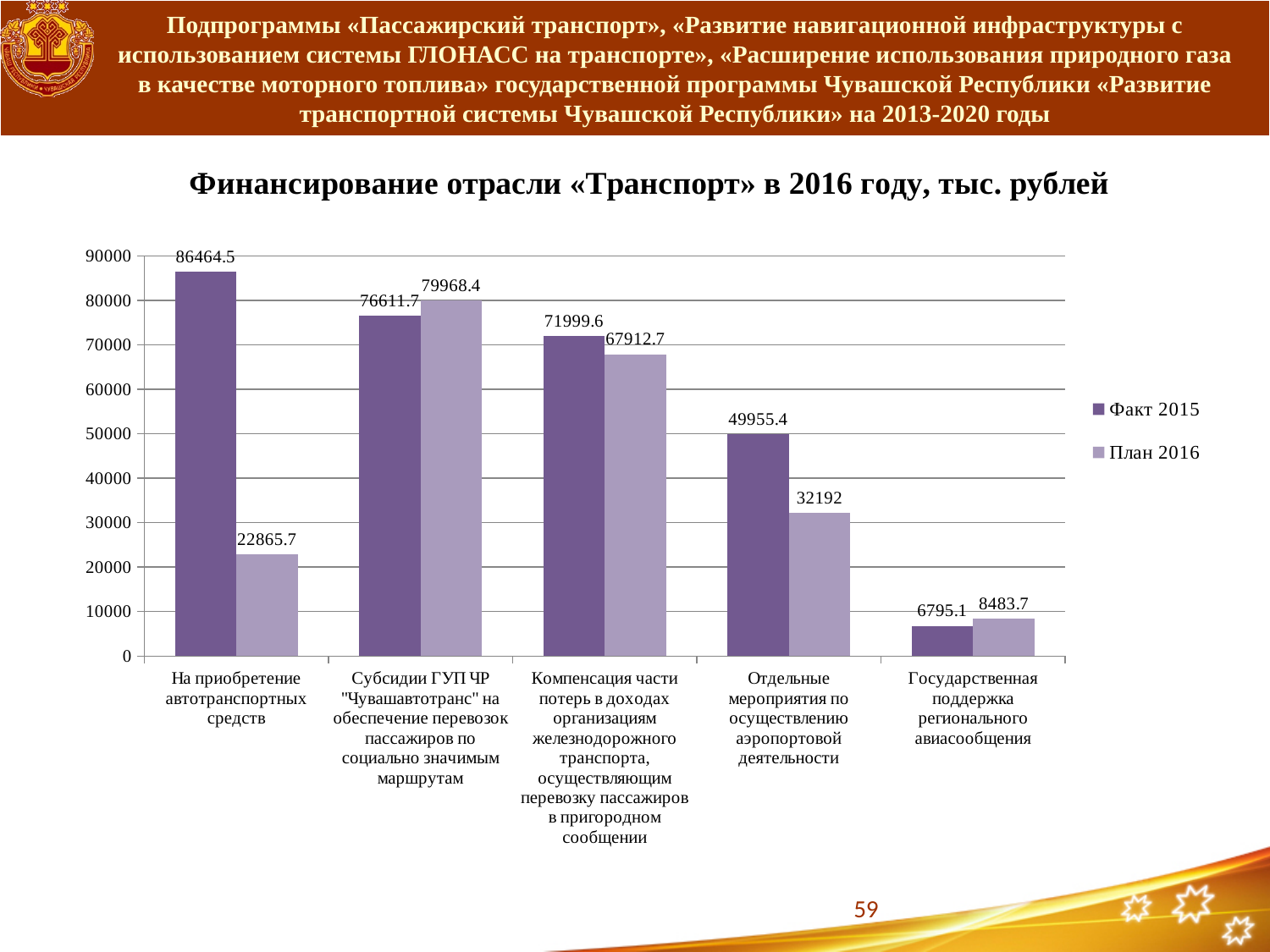
How many series does the legend list? 2 For «Компенсация части потерь в доходах организациям железнодорожного транспорта...», which is larger: Факт 2015 or План 2016? Факт 2015 What is the Факт 2015 value for «На приобретение автотранспортных средств»? 86464.5 How many categories are shown on the x axis? 5 Which category has the highest Факт 2015 value? На приобретение автотранспортных средств What is the План 2016 value for «Отдельные мероприятия по осуществлению аэропортовой деятельности»? 32192 What is the difference between the Факт 2015 and План 2016 values for «На приобретение автотранспортных средств»? 63598.8 What is the План 2016 value for «Государственная поддержка регионального авиасообщения»? 8483.7 Is the План 2016 value for «Отдельные мероприятия по осуществлению аэропортовой деятельности» greater or less than 40000? less Which category has the lowest План 2016 value? Государственная поддержка регионального авиасообщения What kind of chart is shown on the slide? bar chart What is the difference between the План 2016 and Факт 2015 values for «Субсидии ГУП ЧР "Чувашавтотранс" на обеспечение перевозок пассажиров по социально значимым маршрутам»? 3356.7